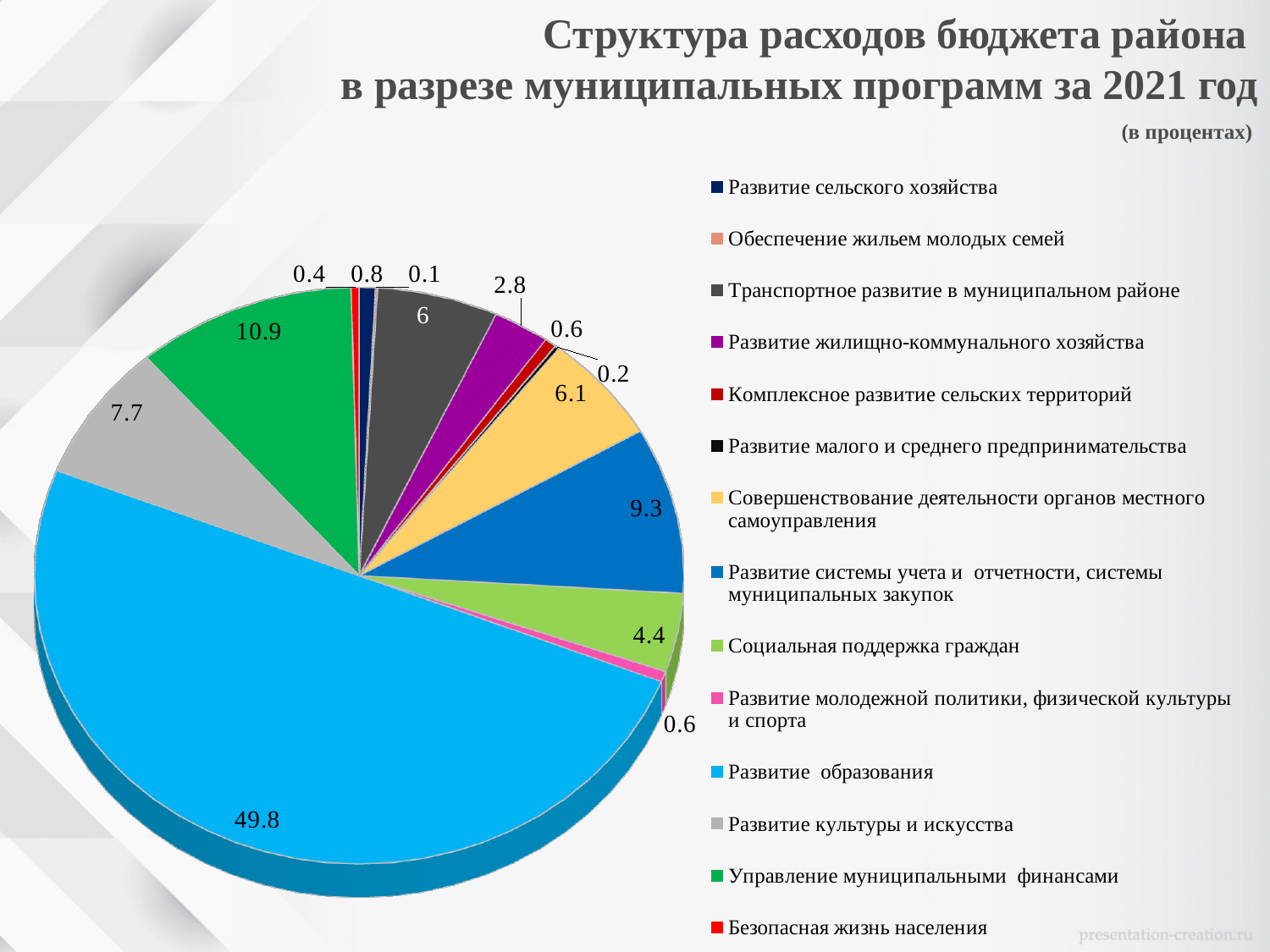
What is the value for Развитие образования? 49.8 What is the title of the chart? Структура расходов бюджета района в разрезе муниципальных программ за 2021 год Which category has the largest share of the pie? Развитие образования Which category has the smallest share of the pie? Обеспечение жильем молодых семей What is the difference between the values for Управление муниципальными финансами and Развитие культуры и искусства? 3.2 What is the value for Развитие системы учета и отчетности, системы муниципальных закупок? 9.3 Which is larger: the value for Совершенствование деятельности органов местного самоуправления or the value for Транспортное развитие в муниципальном районе? Совершенствование деятельности органов местного самоуправления What is the value for Транспортное развитие в муниципальном районе? 6 How many categories does the legend list? 14 What is the value for Управление муниципальными финансами? 10.9 What is the value for Социальная поддержка граждан? 4.4 What kind of chart is shown on the slide? pie chart